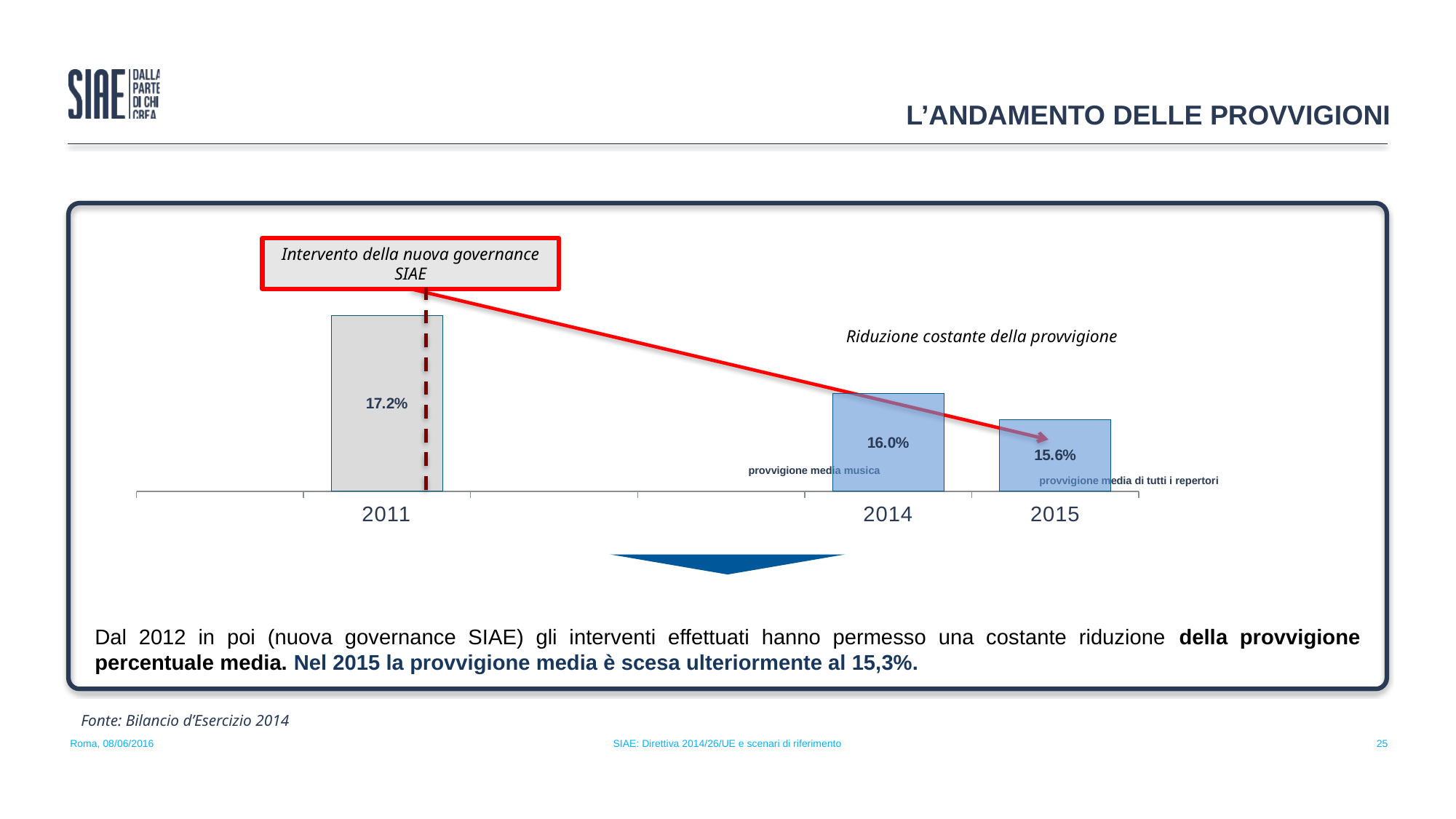
Do the values rise or fall from 2011 to 2015? Fall What is the difference between the 2014 value and the 2015 value? 0.4% What is the value shown for 2015? 15.6% What is the value shown for 2011? 17.2% Which year has the highest value? 2011 Which is larger, the value for 2011 or the value for 2014? 2011 What is the difference between the 2011 value and the 2015 value? 1.6% What is the title of the slide containing the chart? L'ANDAMENTO DELLE PROVVIGIONI What is the value shown for 2014? 16.0% How many years are plotted as bars in the chart? 3 Which year has the lowest value? 2015 What kind of chart is shown on the slide? Bar chart